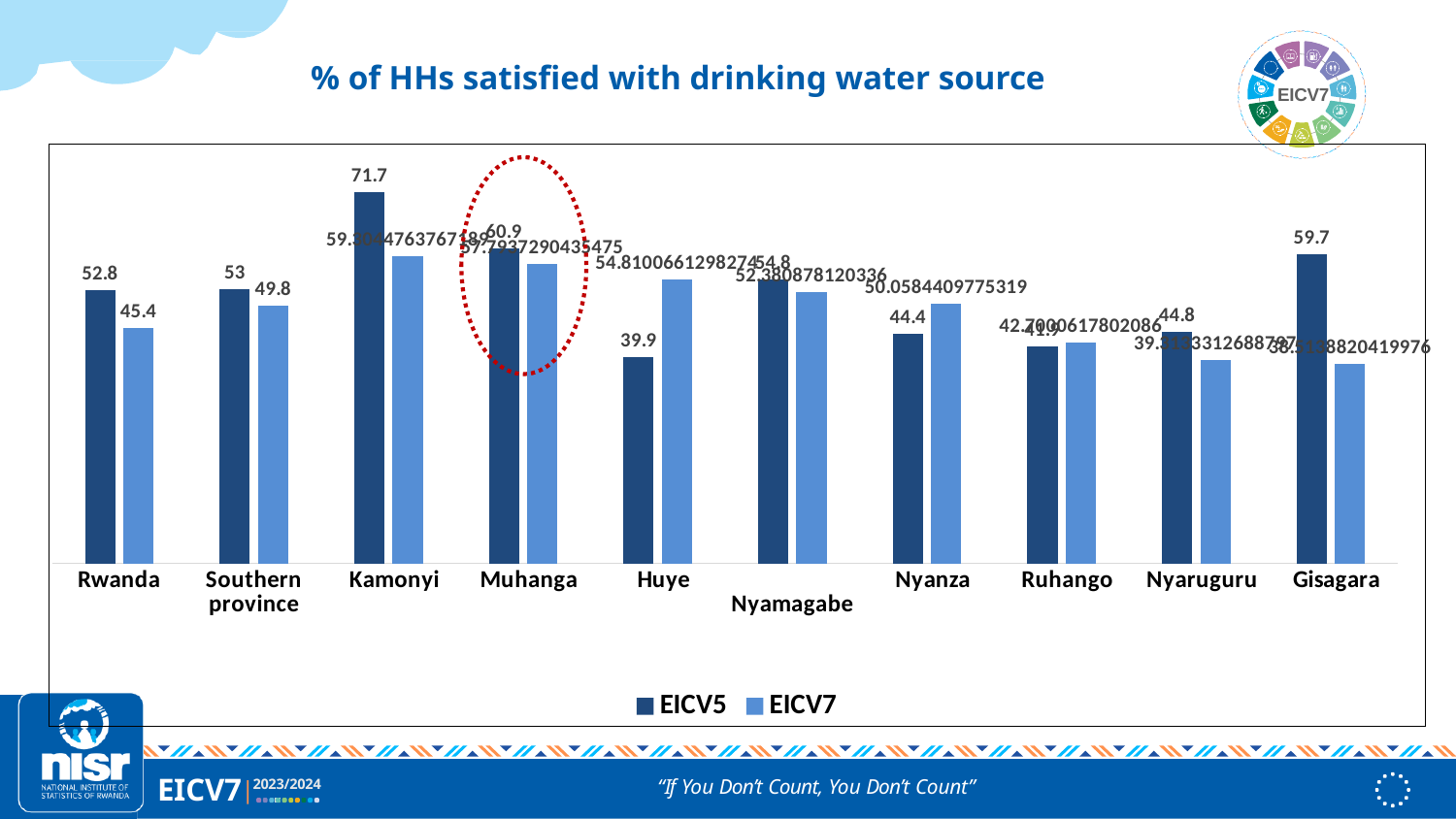
What is the EICV5 value for Huye? 39.9 Which category has the highest EICV5 value? Kamonyi What is the difference between the EICV5 and EICV7 values for Rwanda? 7.4 Which category has the lowest EICV5 value? Huye What is the EICV5 value for Kamonyi? 71.7 How many series does the legend list? 2 What kind of chart is shown on the slide? bar chart For Huye, which is larger, the EICV5 value or the EICV7 value? EICV7 What is the EICV5 value for Rwanda? 52.8 What is the EICV7 value for Rwanda? 45.4 What is the title of the chart? % of HHs satisfied with drinking water source How many categories are shown on the x axis? 10